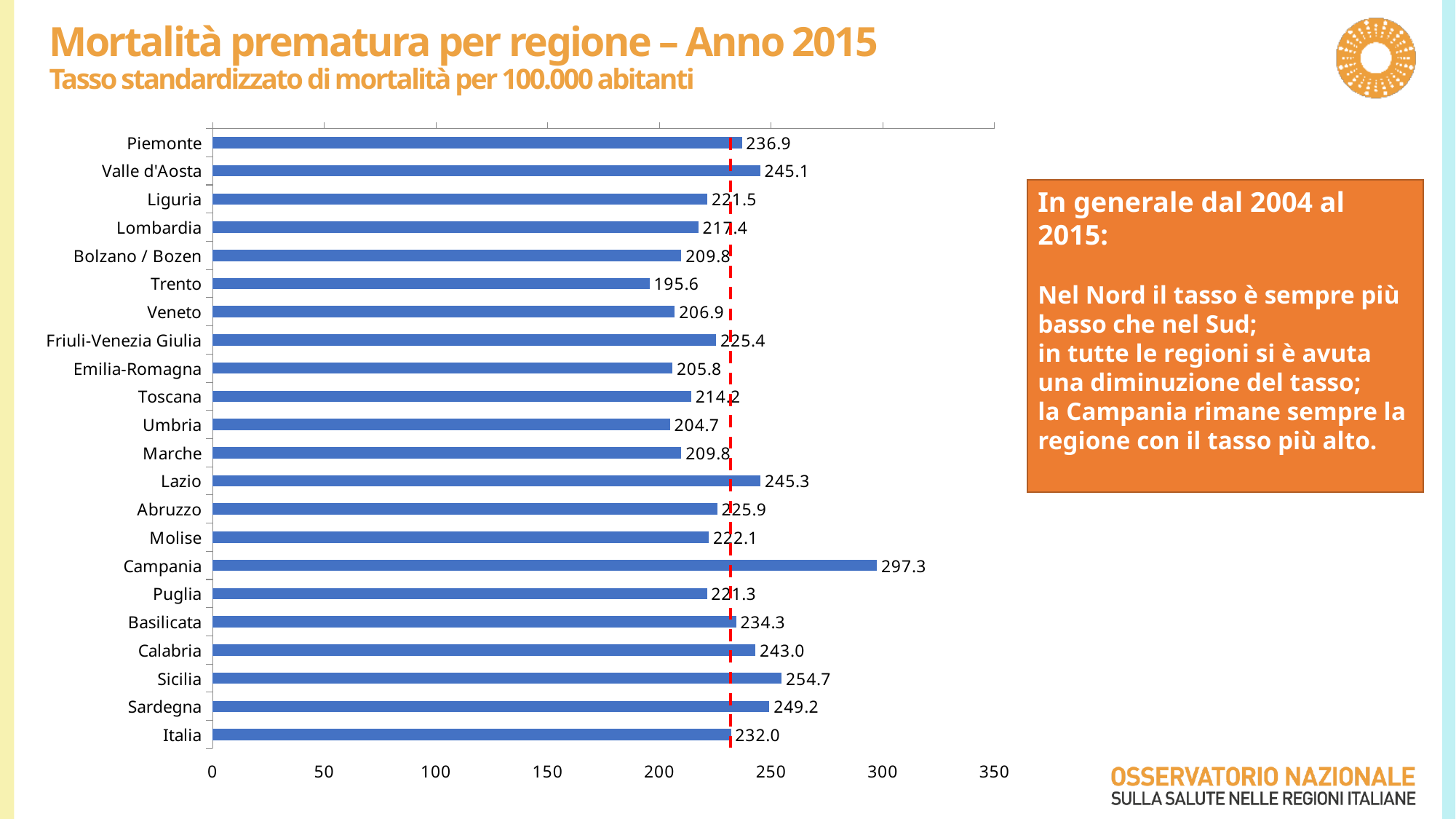
What is the value for Italia? 232.0 How many bars are shown in the chart? 22 What kind of chart is shown on the slide? bar chart What is the difference between the values for Campania and Italia? 65.3 What is the value for Sardegna? 249.2 What is the value for Campania? 297.3 What is the difference between the values for Sicilia and Sardegna? 5.5 What is the value for Trento? 195.6 Is the value for Trento greater or less than 200? less Which region has the lowest value? Trento Which is larger, the value for Sicilia or the value for Calabria? Sicilia Which region has the highest value? Campania